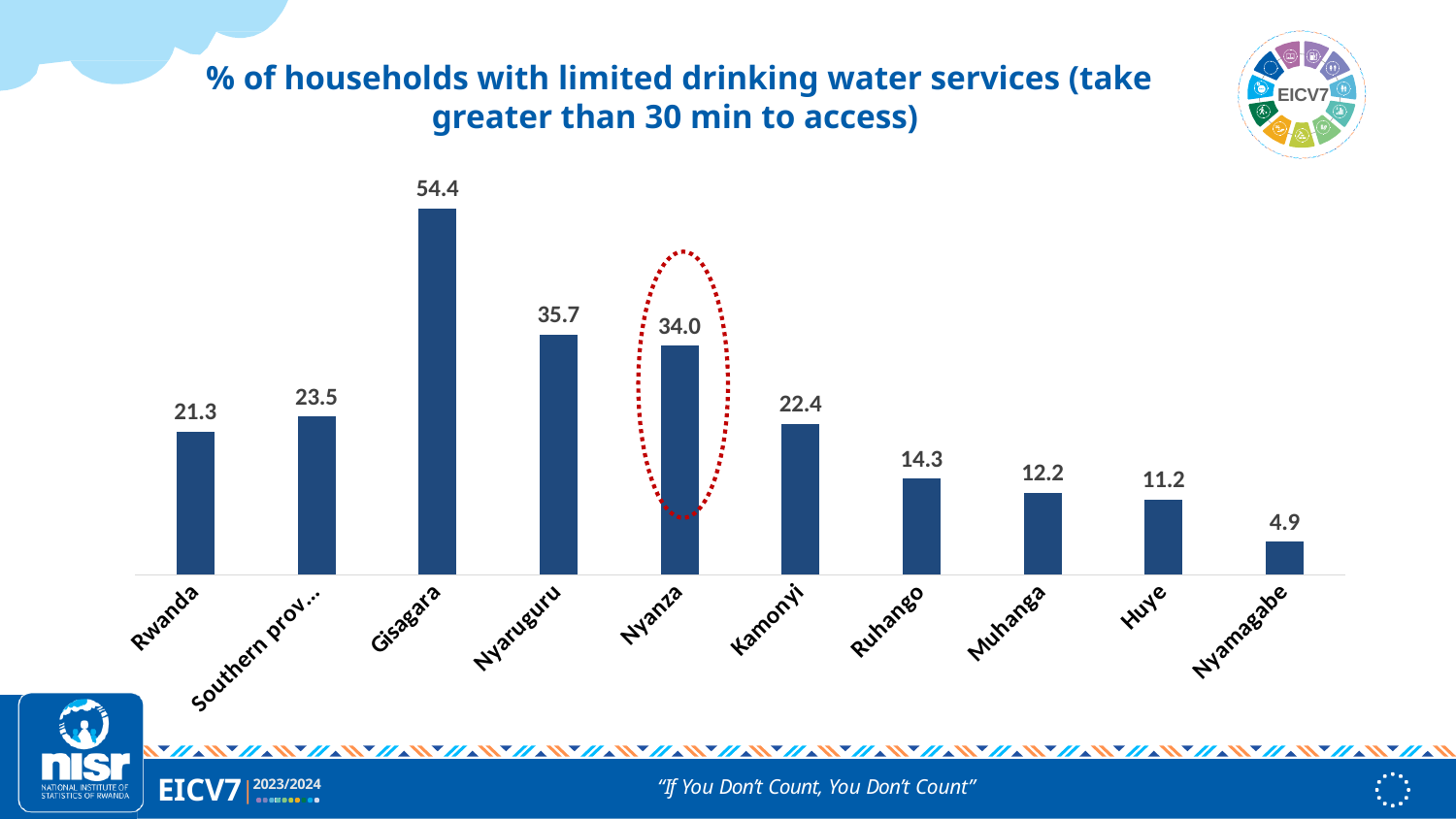
What kind of chart is this? Bar chart Which category has the highest value? Gisagara What is the difference between the values for Gisagara and Nyaruguru? 18.7 What is the value for Nyanza? 34.0 What is the difference between the values for Nyanza and Rwanda? 12.7 Which category is highlighted with a red dotted ellipse? Nyanza What is the value for Rwanda? 21.3 How many categories are shown on the x axis? 10 Which category has the lowest value? Nyamagabe What is the value for Gisagara? 54.4 What is the value for Nyamagabe? 4.9 Which is larger, the value for Kamonyi or the value for Ruhango? Kamonyi